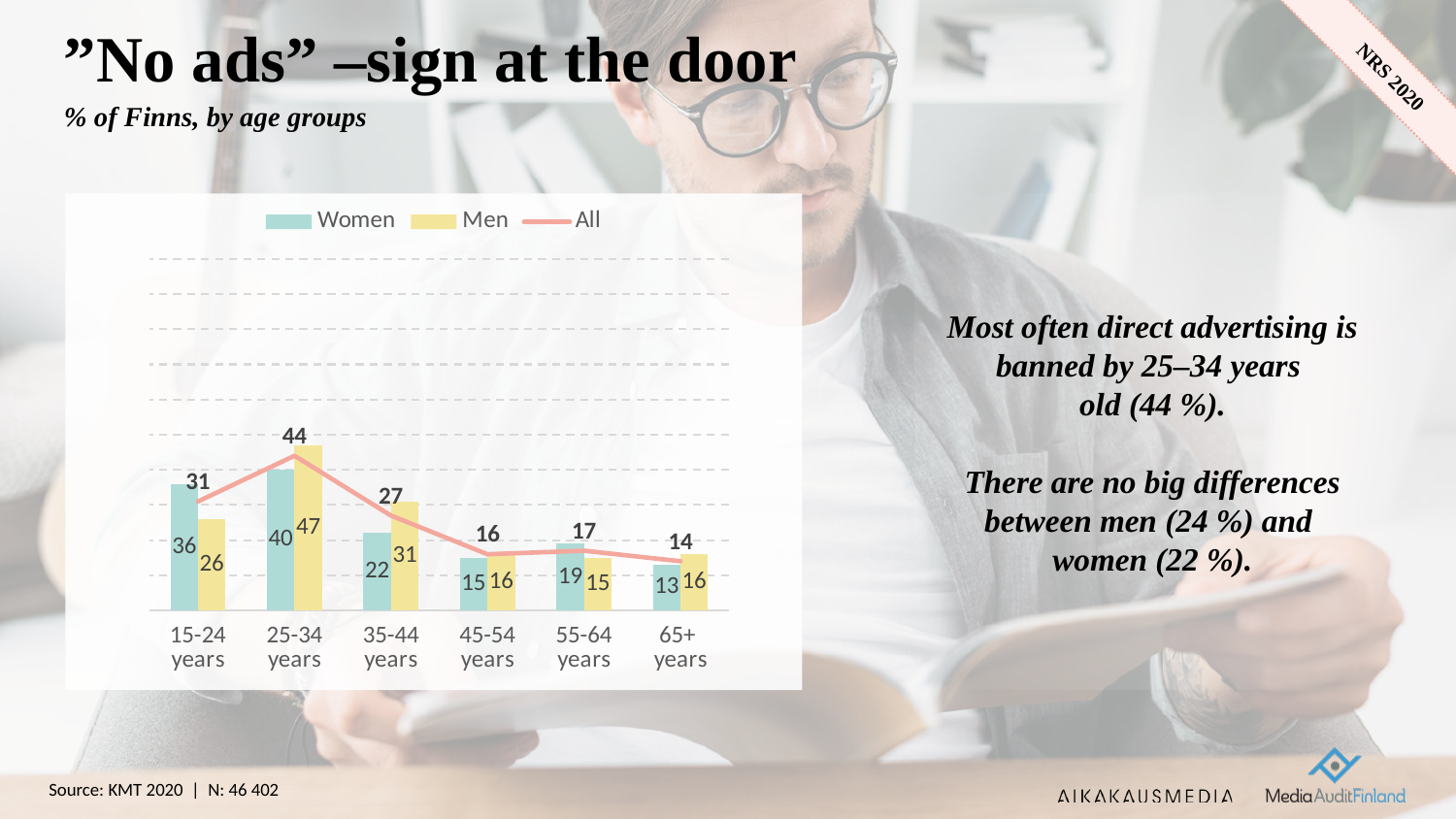
What is the value for Men in the 35-44 years age group? 31 Which age group has the highest value for the All series? 25-34 years What is the value of the All line for the 65+ years age group? 14 How many series does the legend list? 3 Which is larger in the 55-64 years age group, the Women value or the Men value? Women What kind of chart is shown on the slide? Combined bar and line chart What is the difference between the Men and Women values in the 15-24 years age group? 10 What is the value for Women in the 25-34 years age group? 40 Which series is drawn as a line rather than bars? All Does the All line rise or fall from the 25-34 years group to the 45-54 years group? Fall Which age group has the lowest value for Women? 65+ years How many age groups are shown on the x axis? 6